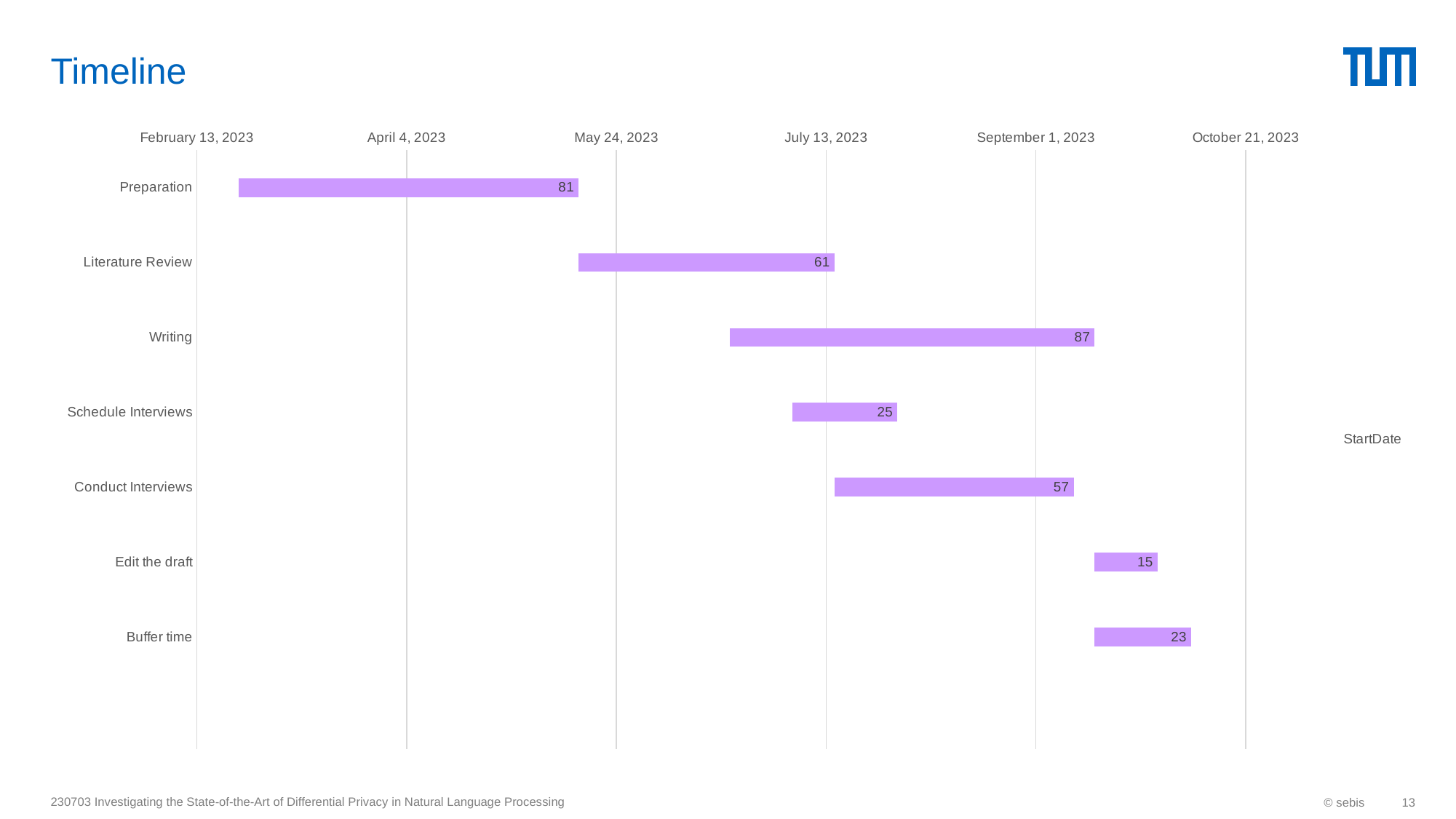
What is the difference between the values for Writing and Preparation? 6 What is the value shown for Buffer time? 23 What kind of chart is shown on the slide? Bar chart What is the difference between the values for Conduct Interviews and Schedule Interviews? 32 Which task has the highest value? Writing What is the value shown for Literature Review? 61 Which has a larger value, Literature Review or Conduct Interviews? Literature Review What is the value shown for Preparation? 81 Which task has the lowest value? Edit the draft What is the value shown for Conduct Interviews? 57 What is the title of the slide containing the chart? Timeline How many tasks are shown in the chart? 7